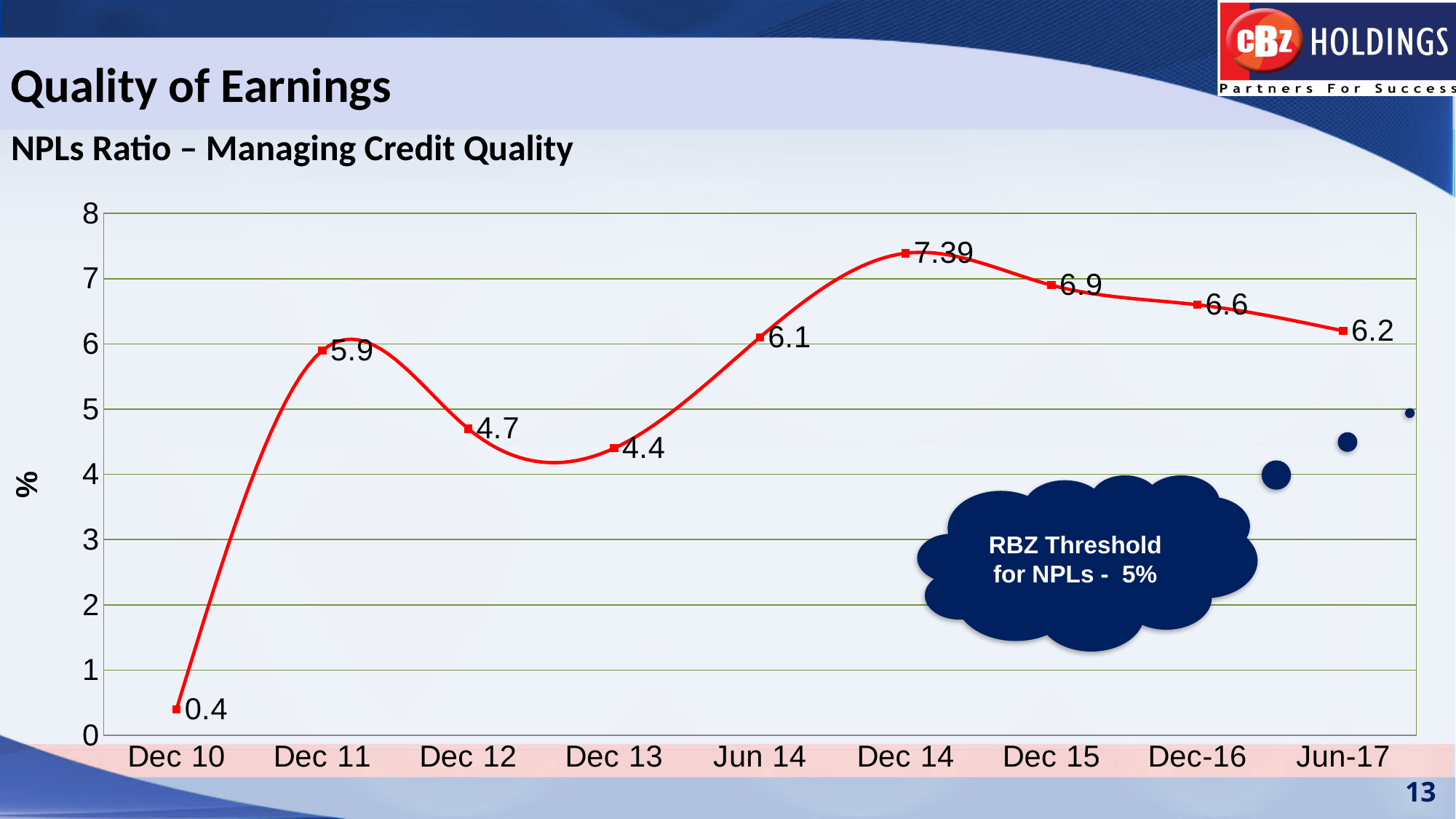
Which period has the highest NPLs ratio? Dec 14 What kind of chart is shown on the slide? line chart Is the NPLs ratio for Jun 14 greater or less than 5? greater How many periods are plotted on the x axis? 9 Which period has the lowest NPLs ratio? Dec 10 What is the NPLs ratio value for Dec 10? 0.4 What is the NPLs ratio value for Dec 13? 4.4 What is the NPLs ratio value for Dec 14? 7.39 What is the NPLs ratio value for Jun-17? 6.2 Which is larger, the NPLs ratio for Dec 11 or Dec 12? Dec 11 What RBZ threshold for NPLs is stated in the callout on the chart? 5% What is the difference between the NPLs ratio for Dec 15 and Dec-16? 0.3